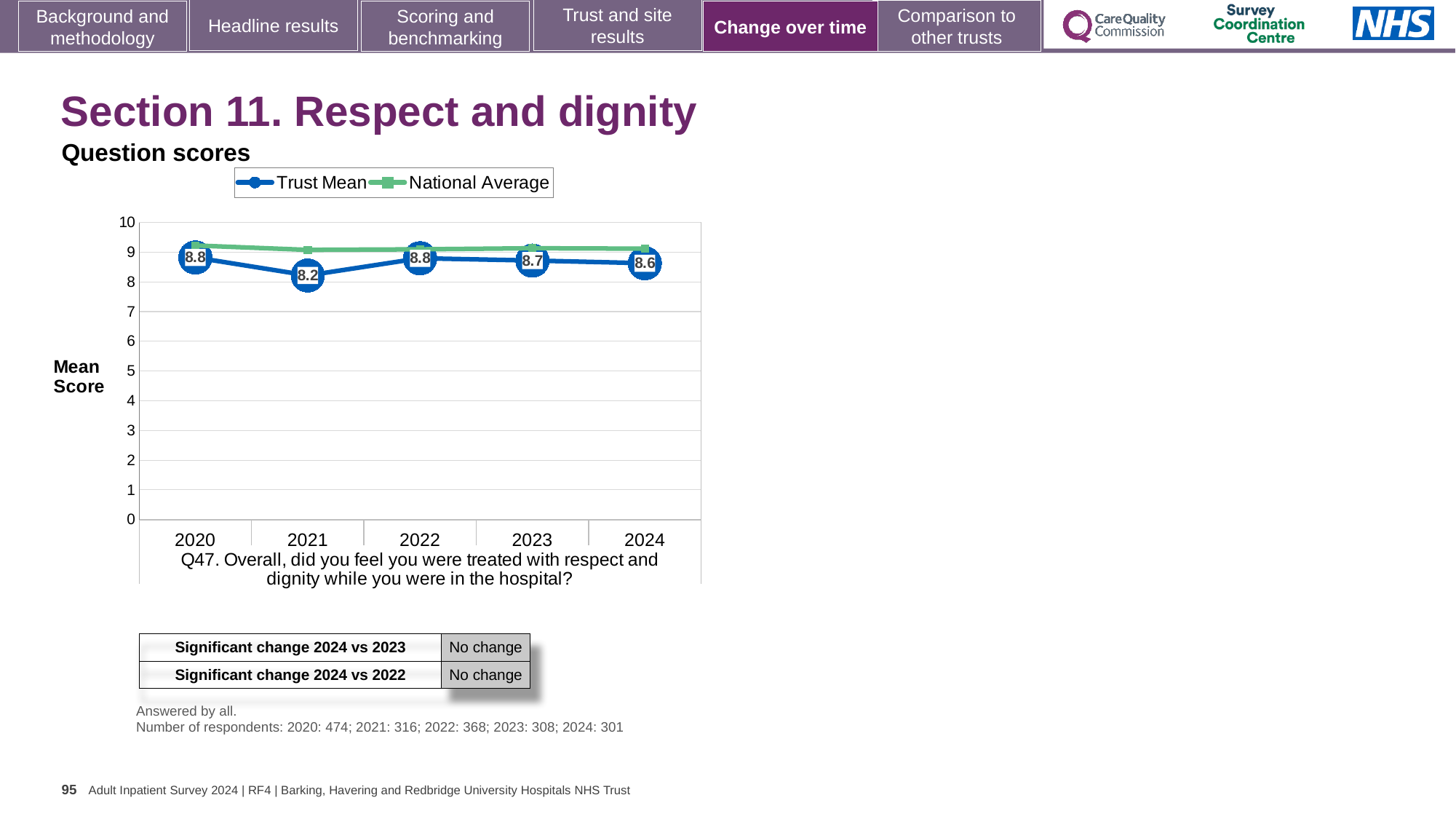
What is the Trust Mean score for 2023? 8.7 What is the Trust Mean score for 2021? 8.2 In which year is the Trust Mean score lowest? 2021 What is the difference between the Trust Mean scores for 2020 and 2021? 0.6 What is the label on the y axis of the chart? Mean Score Does the Trust Mean score rise or fall from 2022 to 2024? Fall Which year has the higher Trust Mean score, 2023 or 2024? 2023 What is the Trust Mean score for 2024? 8.6 How many years are plotted on the x axis? 5 Is the National Average value for 2021 greater or less than 8? greater How many series does the legend list? 2 What kind of chart is shown on the slide? Line chart